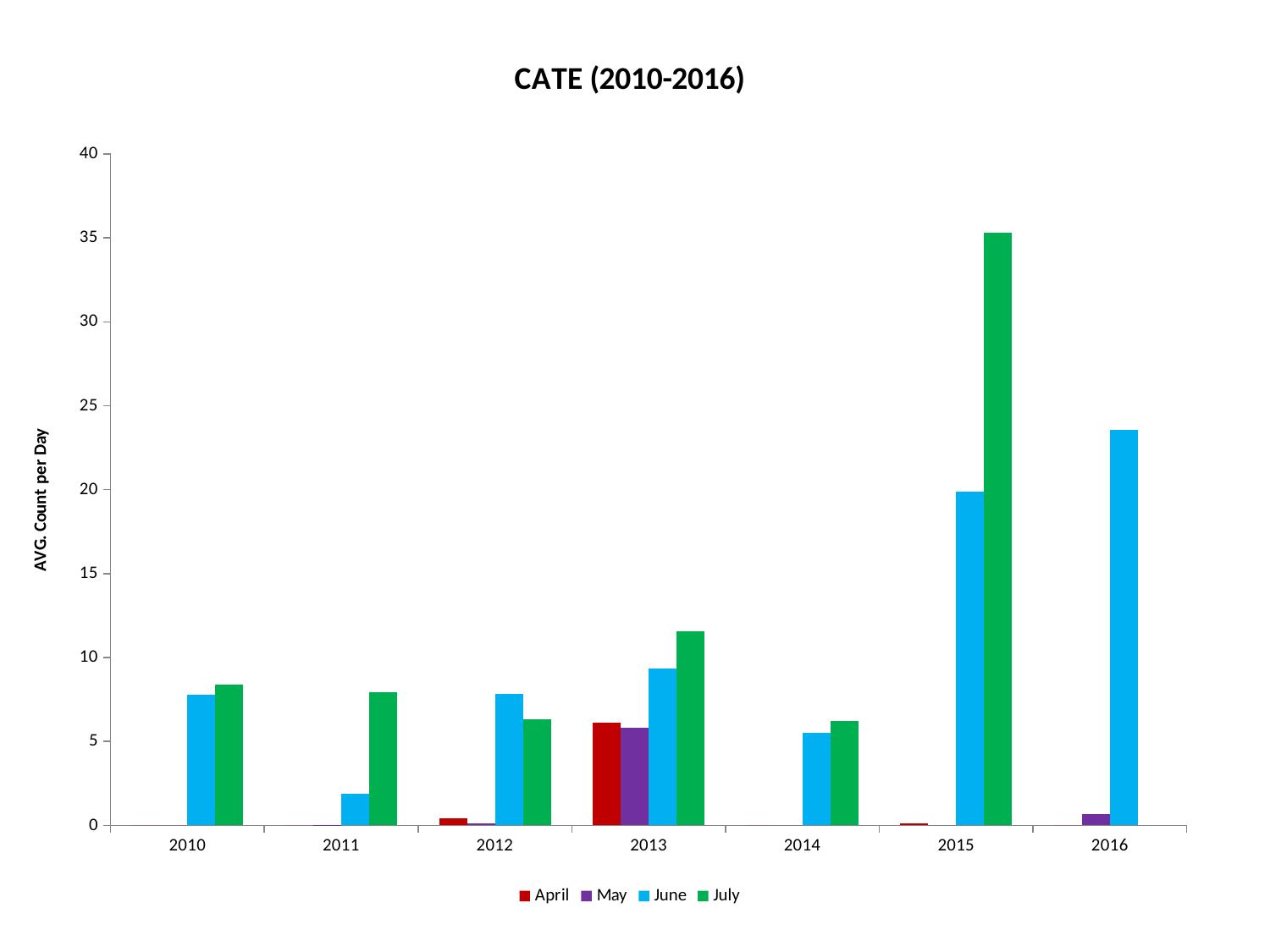
How many years are shown along the x axis? 7 What kind of chart is shown on the slide? bar chart In 2012, which is larger, the June value or the July value? June Is the July value for 2015 greater or less than 30? greater In 2013, which is larger, the June value or the July value? July How many series does the legend list? 4 In which year is the June value highest? 2016 Is the July value for 2013 greater or less than 10? greater In which year is the July value highest? 2015 Is the June value for 2016 greater or less than 20? greater What is the title of the y axis? AVG. Count per Day